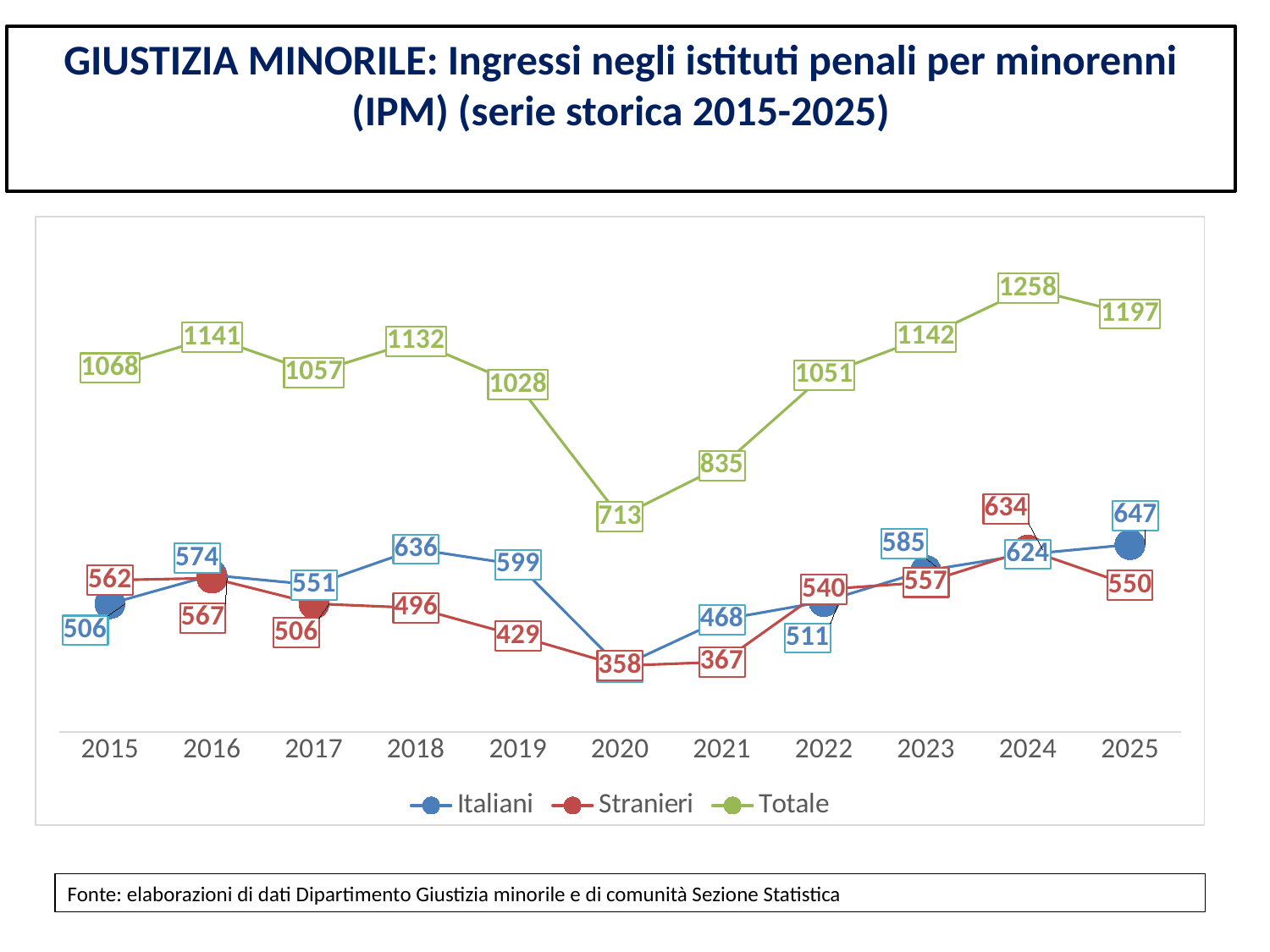
How many series does the legend list? 3 What is the value of the Italiani series in 2025? 647 How many years are shown on the x axis? 11 In which year is the Totale series at its highest? 2024 What is the value of the Stranieri series in 2019? 429 In 2022, which series has the larger value, Italiani or Stranieri? Stranieri In which year does the Italiani series reach its highest value? 2025 In which year is the Totale series at its lowest? 2020 What kind of chart is shown on the slide? Line chart What is the value of the Totale series in 2024? 1258 Does the Totale series rise or fall from 2020 to 2024? Rise By how much did the Totale value fall from 2024 to 2025? 61